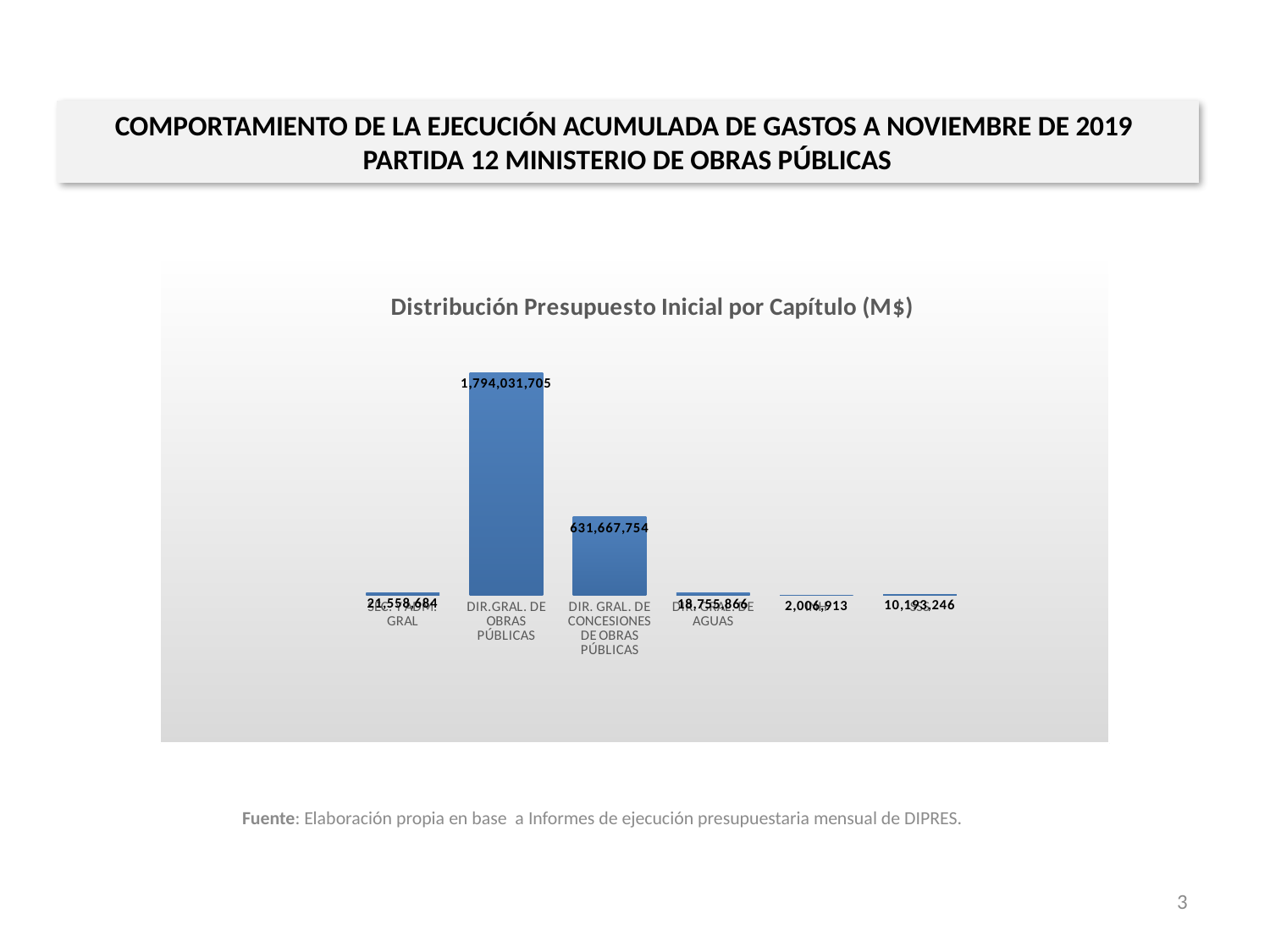
What type of chart is shown on the slide? bar chart Which is larger, the value for DIR.GRAL. DE OBRAS PÚBLICAS or the value for DIR. GRAL. DE CONCESIONES DE OBRAS PÚBLICAS? DIR.GRAL. DE OBRAS PÚBLICAS How many bars (categories) are plotted in the chart? 6 What is the smallest value labelled in the chart? 2,006,913 What is the value shown for DIR.GRAL. DE OBRAS PÚBLICAS? 1,794,031,705 What is the title of the chart? Distribución Presupuesto Inicial por Capítulo (M$) In what unit are the chart values expressed, according to the chart title? M$ What is the value shown for DIR. GRAL. DE AGUAS? 18,755,866 What is the value shown for DIR. GRAL. DE CONCESIONES DE OBRAS PÚBLICAS? 631,667,754 What is the difference between the values for DIR.GRAL. DE OBRAS PÚBLICAS and DIR. GRAL. DE CONCESIONES DE OBRAS PÚBLICAS? 1,162,363,951 What is the value labelled on the leftmost bar of the chart? 21,558,684 Which category has the highest value in the chart? DIR.GRAL. DE OBRAS PÚBLICAS